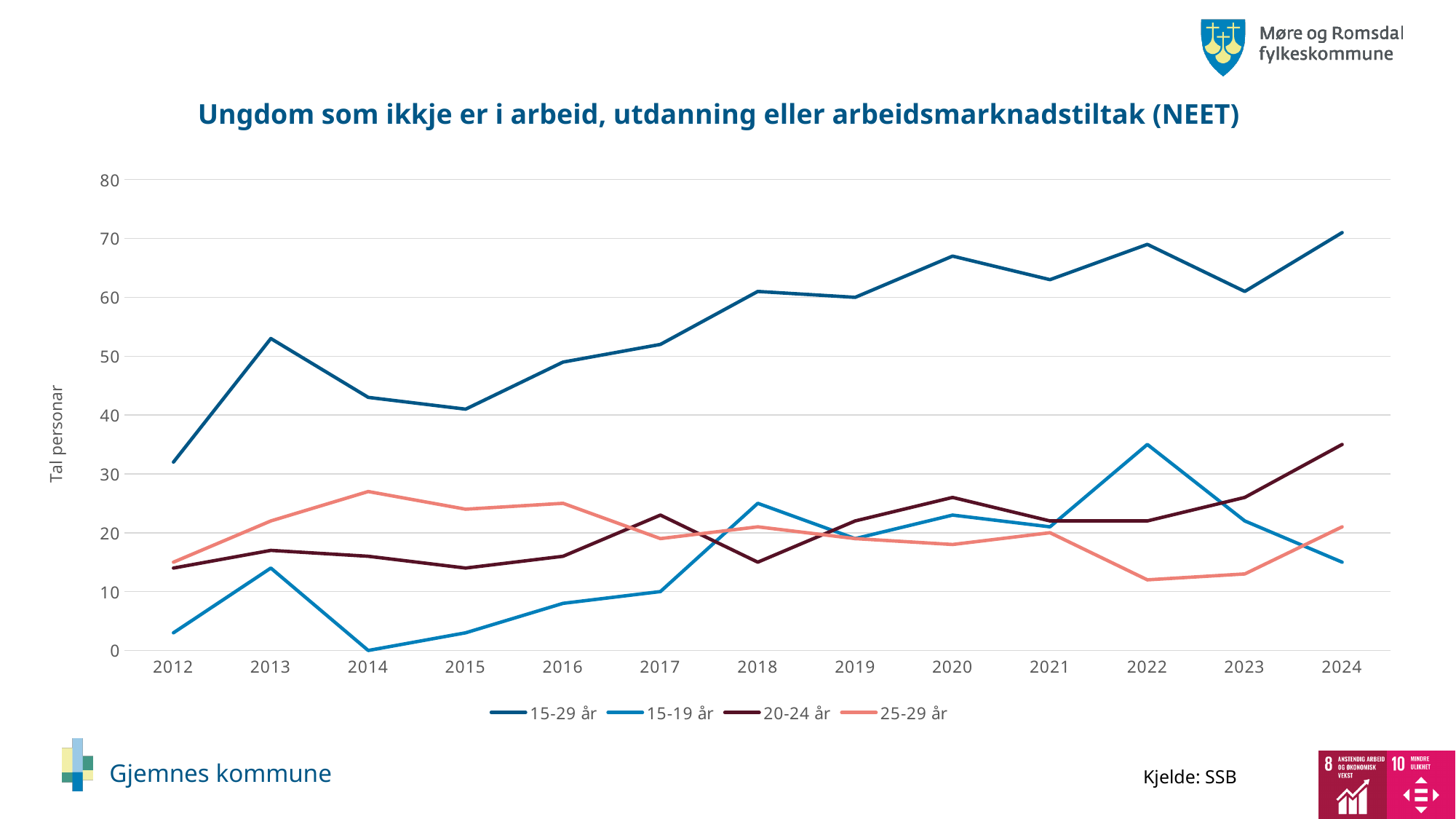
How many series does the legend list? 4 Is the value for 15-29 år in 2012 greater or less than 40? less In 2018, which is larger: 15-19 år or 20-24 år? 15-19 år What kind of chart is shown on the slide? line chart Is the value for 20-24 år in 2024 greater or less than 30? greater In which year is the 20-24 år series at its highest? 2024 Does the 15-29 år series generally rise or fall from 2012 to 2024? rise What is the value for 15-29 år in 2019? 60 How many years are shown on the x axis? 13 In which year is the 15-19 år series at its highest? 2022 In which year is the 15-19 år series at its lowest? 2014 What is the value for 15-19 år in 2014? 0